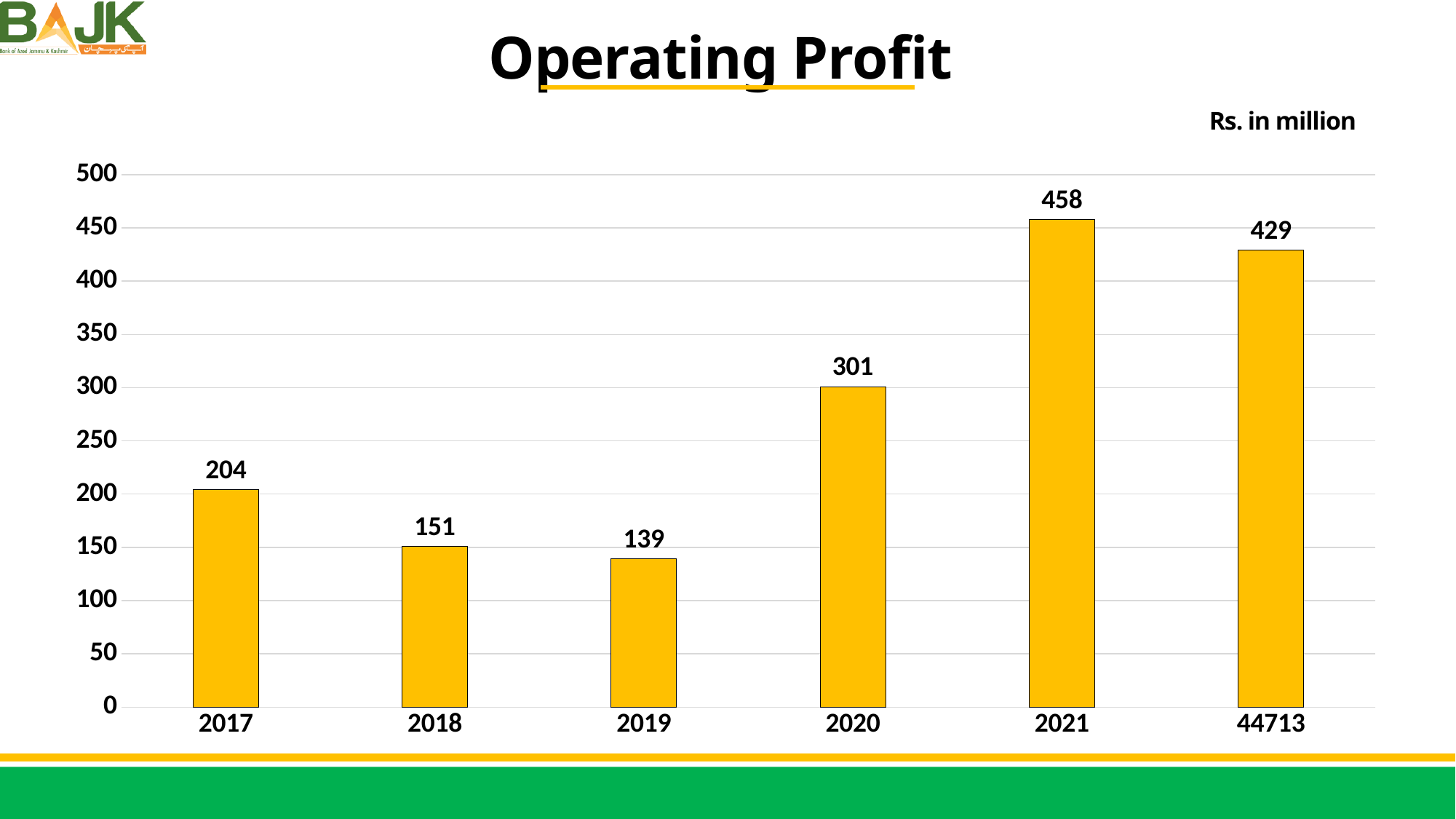
Which is larger, the operating profit in 2018 or in 2019? 2018 What is the value shown for the category labelled 44713? 429 What is the difference between the operating profit in 2017 and in 2018? 53 Does the operating profit rise or fall from 2019 to 2021? Rise What kind of chart is shown on the slide? Bar chart What is the operating profit for 2020? 301 What is the operating profit for 2017? 204 Which year has the lowest operating profit? 2019 How many bars are shown in the chart? 6 Which year has the highest operating profit? 2021 What is the difference between the operating profit in 2021 and in 2020? 157 What unit is stated for the values in the chart? Rs. in million